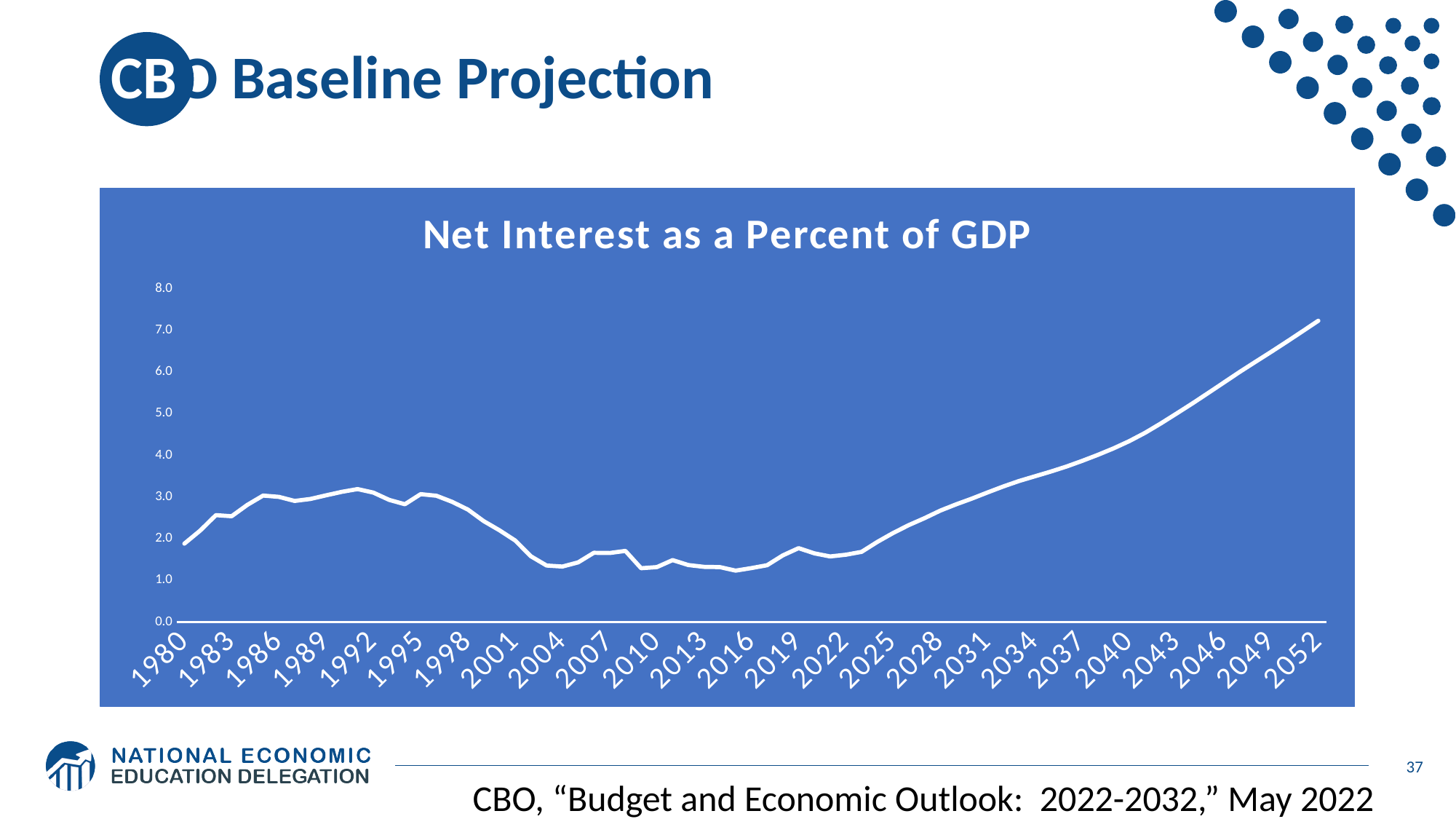
What kind of chart is shown on the slide? line chart Is the value for 2046 greater or less than 5.0? greater Which year has the larger value, 1992 or 2004? 1992 Which year on the x axis has the highest value of net interest as a percent of GDP? 2052 Which year has the larger value, 1980 or 2052? 2052 Is the value for 1980 greater or less than 3.0? less Do the values rise or fall along the x axis from 1992 to 2004? fall What is the title of the chart? Net Interest as a Percent of GDP Is the value for 2016 greater or less than 2.0? less Do the values rise or fall along the x axis from 2025 to 2052? rise How many year labels are shown on the x axis? 25